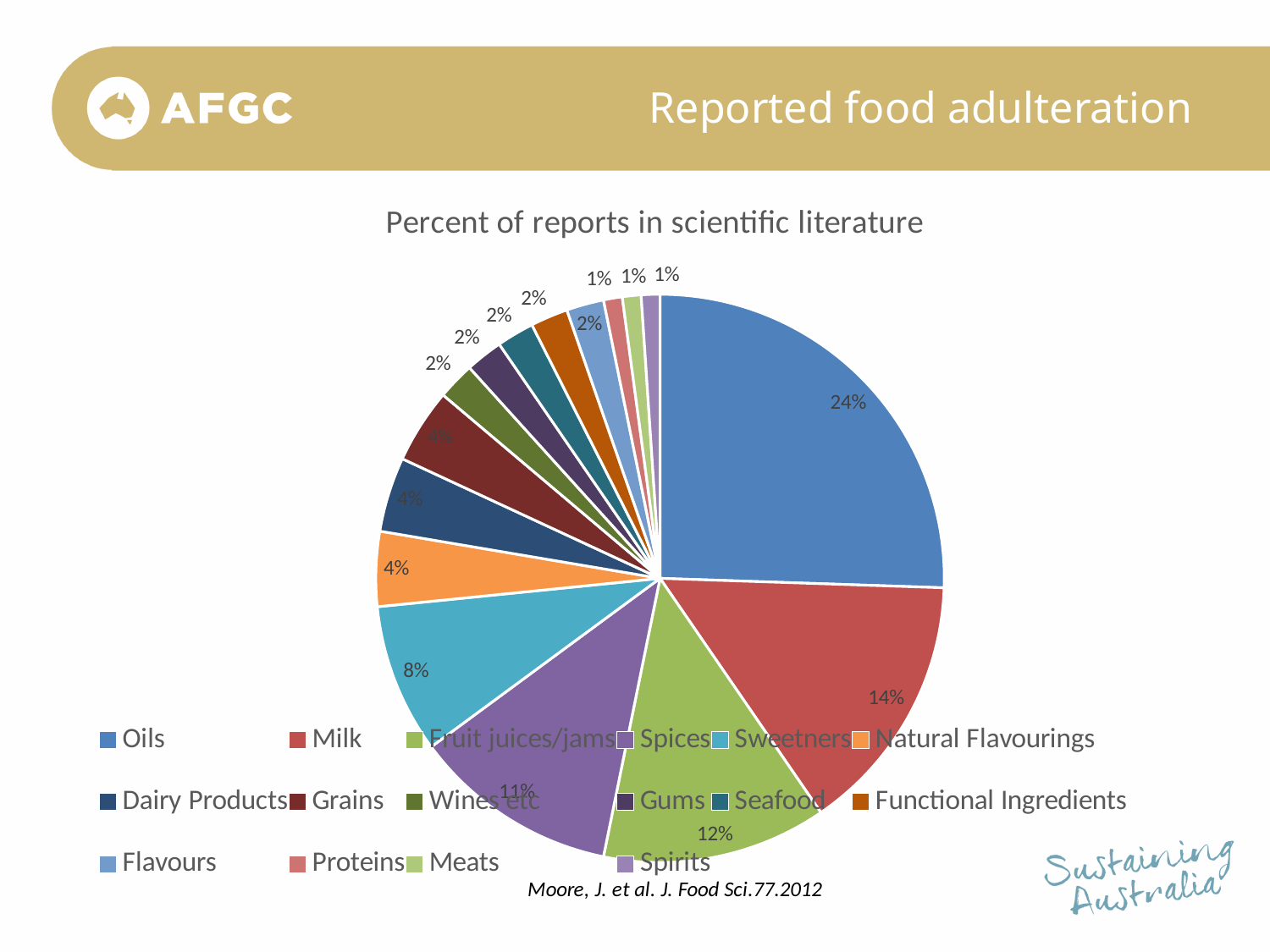
What percentage is shown for Sweetners? 8% What share of the pie does Fruit juices/jams have? 12% What percentage of reports is attributed to Oils? 24% What kind of chart is shown on the slide? pie chart What percentage of reports is attributed to Milk? 14% How many percentage points larger is the Oils share than the Milk share? 10 What is the title of the chart? Percent of reports in scientific literature How many categories does the legend list? 16 Which has a larger share, Milk or Fruit juices/jams? Milk What percentage is shown for Spices? 11% What percentage is shown for Natural Flavourings? 4% Which category has the largest share of the pie? Oils